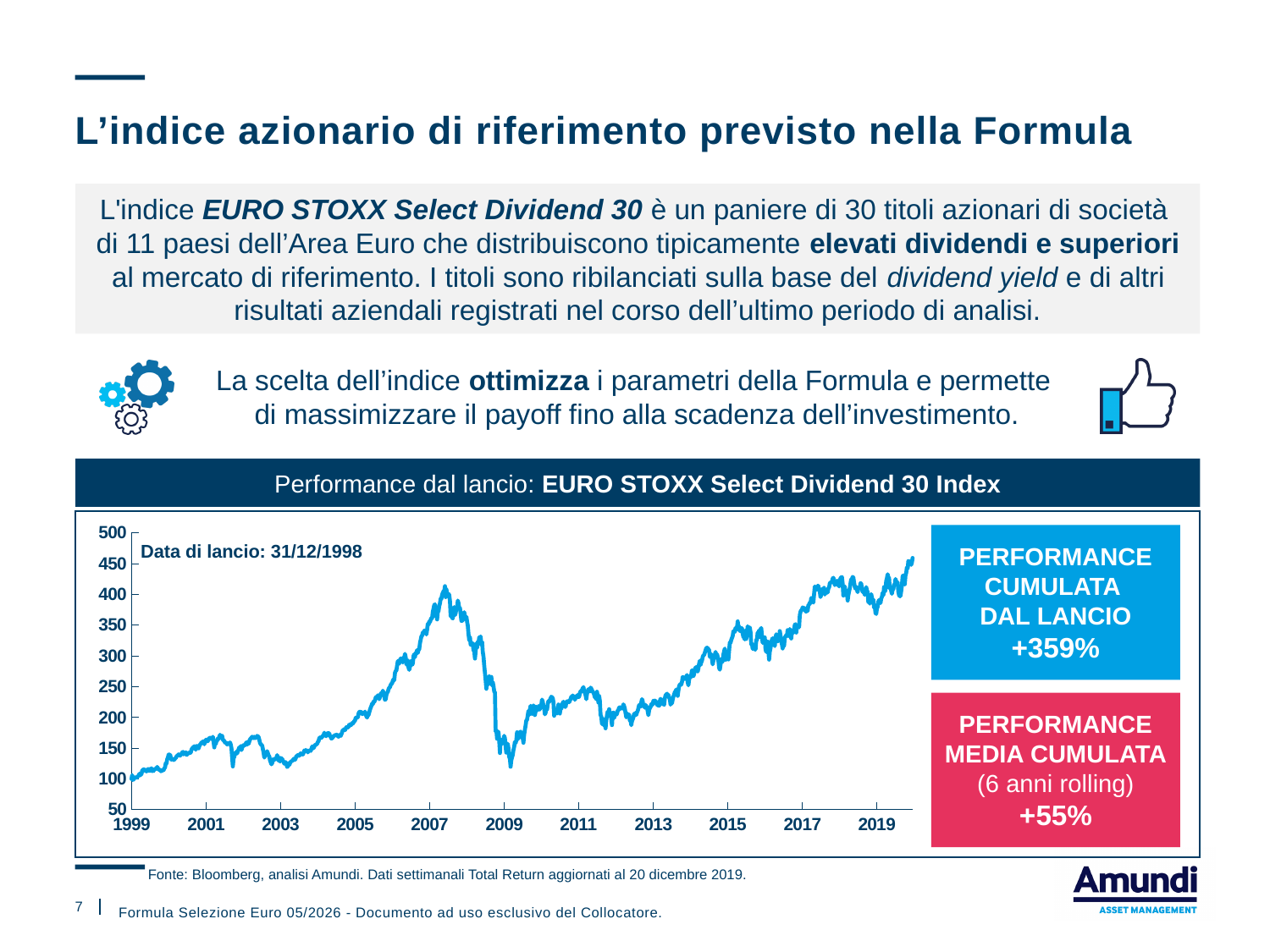
Is the value of the index at the start of 1999 greater or less than 150? less Overall, does the index line rise or fall from 1999 to 2019? rise Is the peak of the index in 2007 greater or less than 350? greater What is the title of the chart on the slide? Performance dal lancio: EURO STOXX Select Dividend 30 Index Is the lowest point of the index in 2009 greater or less than 150? less How many year labels are shown on the x axis of the chart? 11 What launch date (Data di lancio) is printed on the chart? 31/12/1998 Which is higher: the index peak in 2007 or the index level at the end of 2019? end of 2019 Which is higher: the index level in 2005 or in 2015? 2015 What kind of chart is shown under 'Performance dal lancio: EURO STOXX Select Dividend 30 Index'? line chart